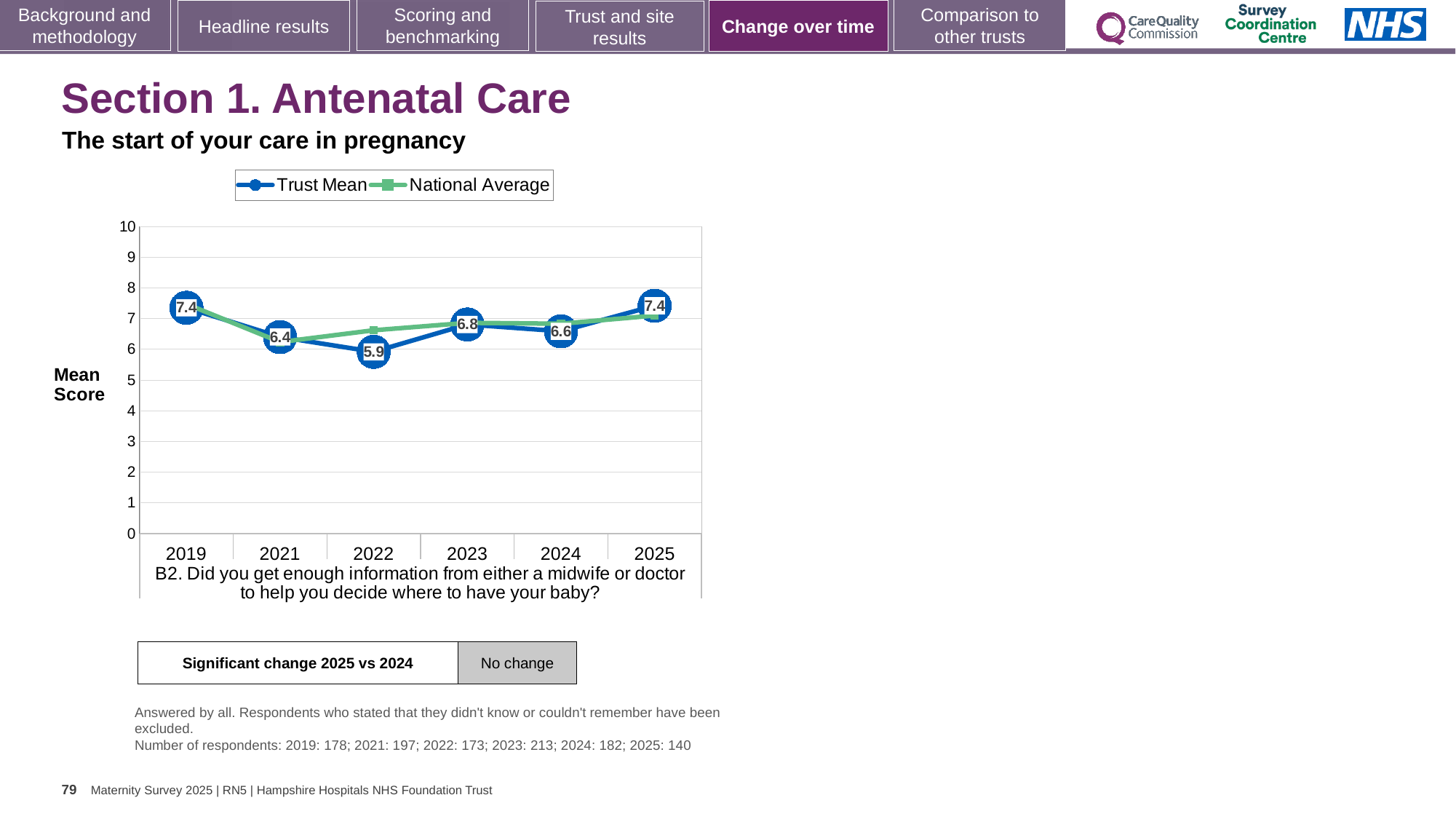
In which year is the Trust Mean score lowest? 2022 What kind of chart is shown on the slide? line chart What is the difference between the Trust Mean scores for 2019 and 2022? 1.5 Which year has the higher Trust Mean score, 2023 or 2024? 2023 How many series does the legend list? 2 What is the Trust Mean score for 2019? 7.4 What is the Trust Mean score for 2022? 5.9 Does the Trust Mean score rise or fall from 2022 to 2025? rise What is the label on the y axis of the chart? Mean Score Is the National Average value for 2022 greater or less than 6? greater How many years are plotted on the x axis? 6 What is the Trust Mean score for 2024? 6.6